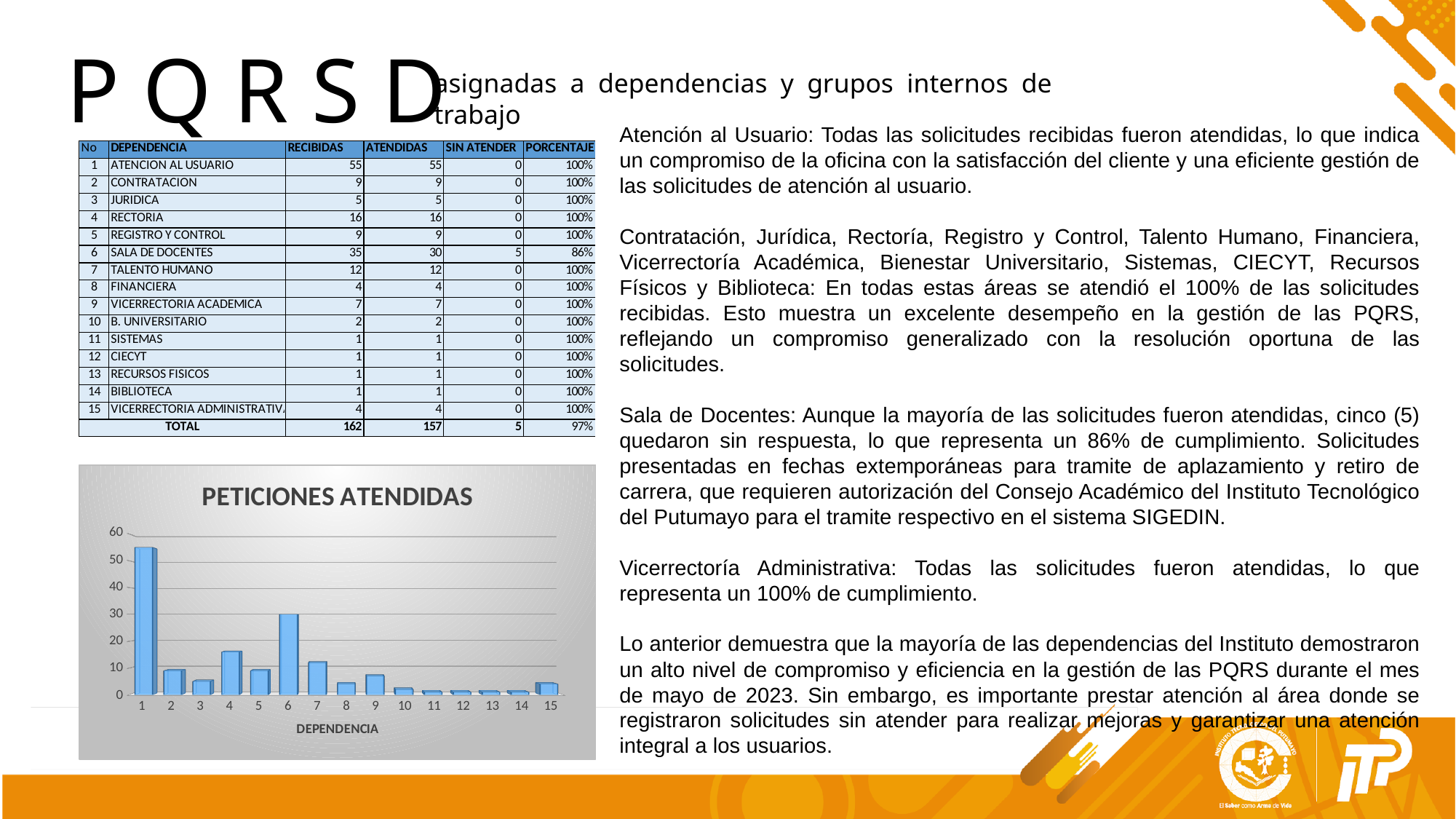
What kind of chart is shown on the slide? bar chart Which has the larger value, category 4 or category 7? 4 Which category has the highest bar in the chart? 1 How many categories are plotted on the x axis of the chart? 15 What is the value for category 6 in the chart? 30 What is the label of the x axis of the chart? DEPENDENCIA Is the value for category 9 greater or less than 10? less Is the value for category 1 greater or less than 50? greater Which has the larger value, category 2 or category 3? 2 Is the value for category 7 greater or less than 10? greater What is the title of the chart? PETICIONES ATENDIDAS